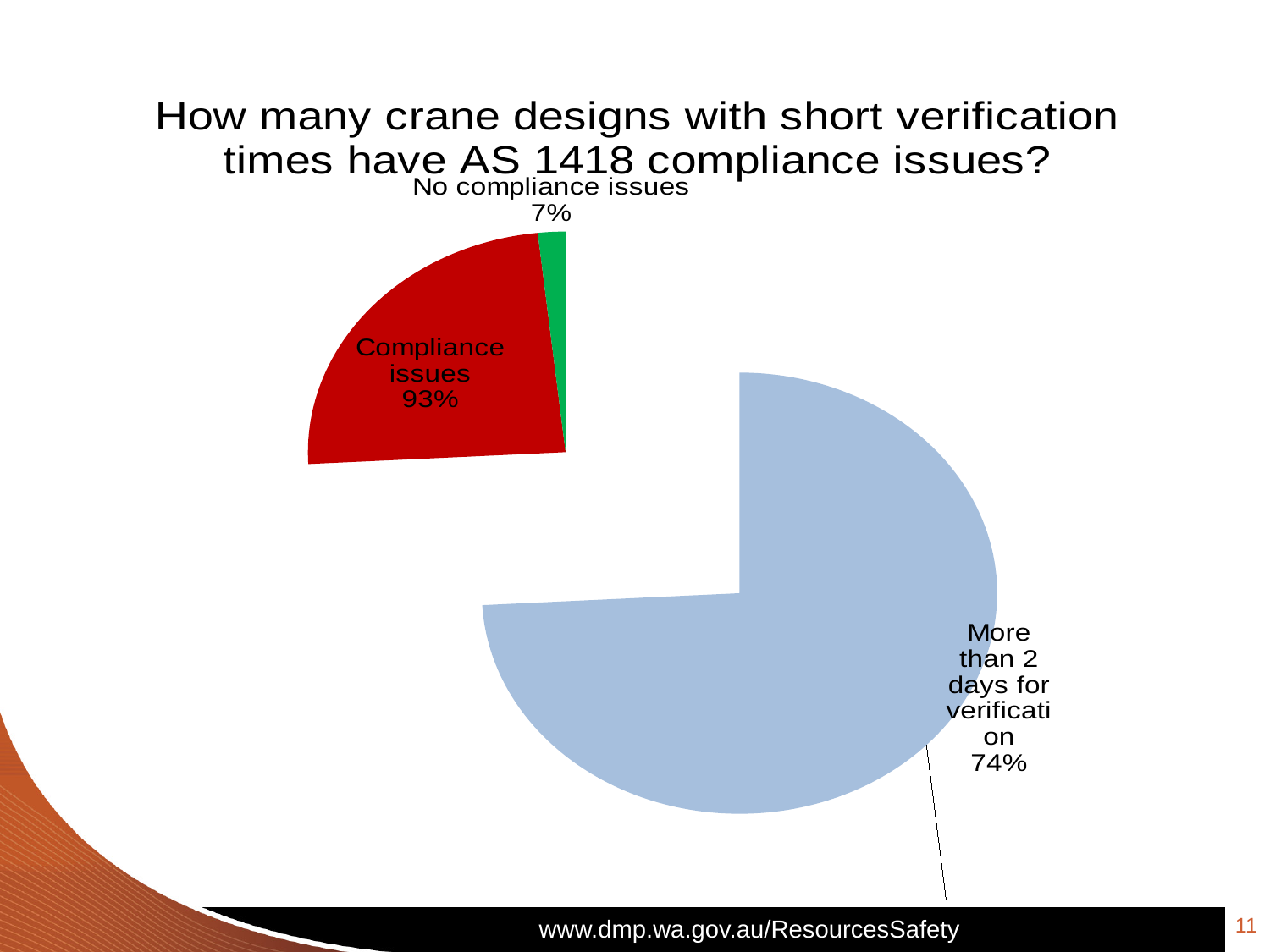
What percentage is shown for the 'Compliance issues' slice? 93% Of the 'Compliance issues' and 'No compliance issues' slices, which has the smaller share? No compliance issues Which labelled slice has the largest percentage on the slide? Compliance issues What percentage is shown for the 'More than 2 days for verification' slice? 74% What is the title of the slide? How many crane designs with short verification times have AS 1418 compliance issues? What kind of chart is shown on the slide? Pie chart What colour is the 'Compliance issues' slice? Red How many labelled slices are shown on the slide? 3 Which is larger, the 'Compliance issues' slice or the 'No compliance issues' slice? Compliance issues What percentage is shown for the 'No compliance issues' slice? 7% What is the difference in percentage points between the 'Compliance issues' slice (93%) and the 'No compliance issues' slice (7%)? 86 percentage points